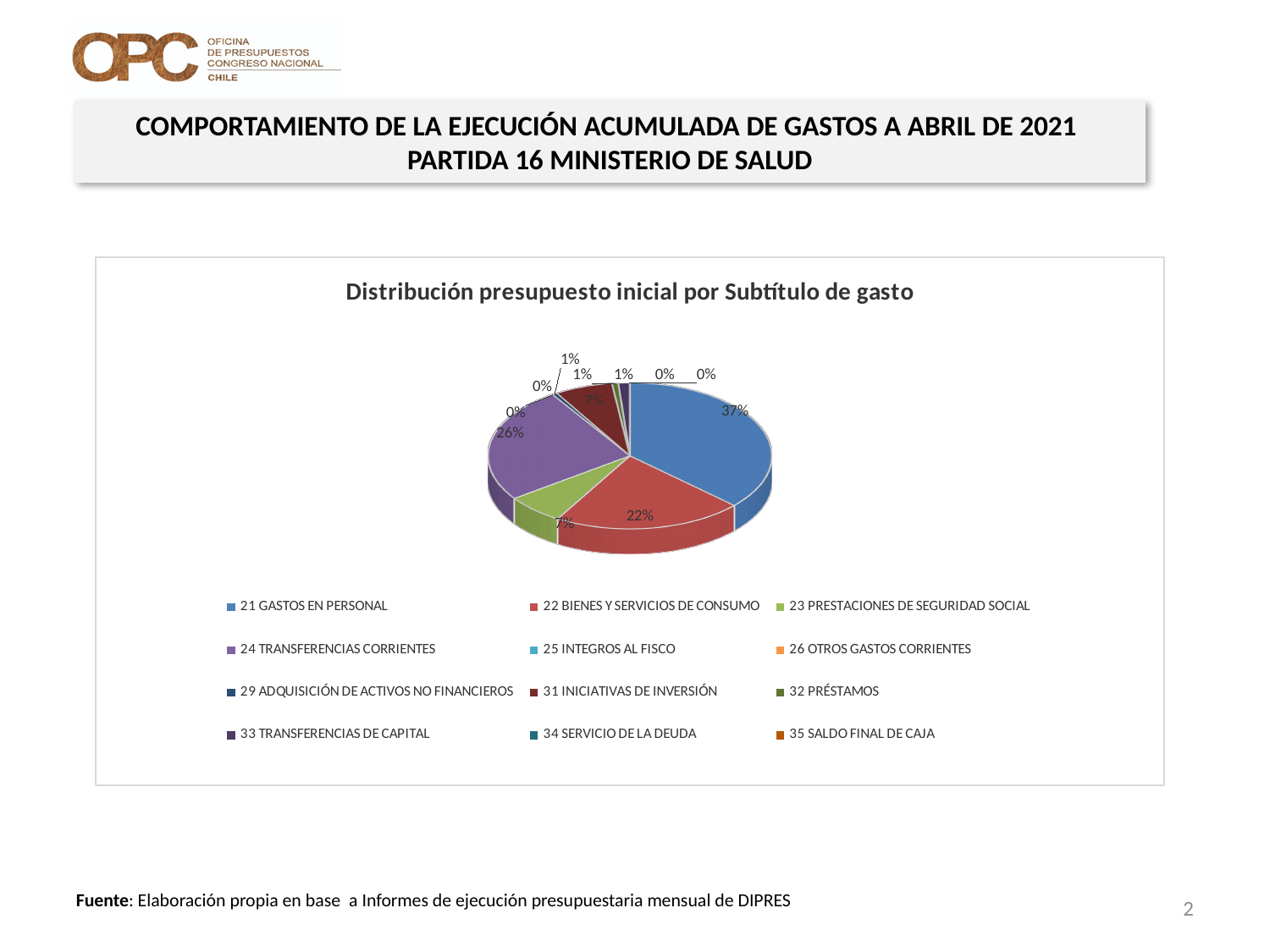
What colour is the slice for 21 GASTOS EN PERSONAL? Blue Which category has the largest share of the pie? 21 GASTOS EN PERSONAL What share of the pie does 23 PRESTACIONES DE SEGURIDAD SOCIAL represent? 7% What kind of chart is shown on the slide? Pie chart Which has a larger share: 22 BIENES Y SERVICIOS DE CONSUMO or 24 TRANSFERENCIAS CORRIENTES? 24 TRANSFERENCIAS CORRIENTES What share of the pie does 22 BIENES Y SERVICIOS DE CONSUMO represent? 22% How many categories does the chart's legend list? 12 What share of the pie does 31 INICIATIVAS DE INVERSIÓN represent? 7% What is the title of the chart? Distribución presupuesto inicial por Subtítulo de gasto What is the difference in percentage points between the shares of 21 GASTOS EN PERSONAL and 22 BIENES Y SERVICIOS DE CONSUMO? 15 percentage points